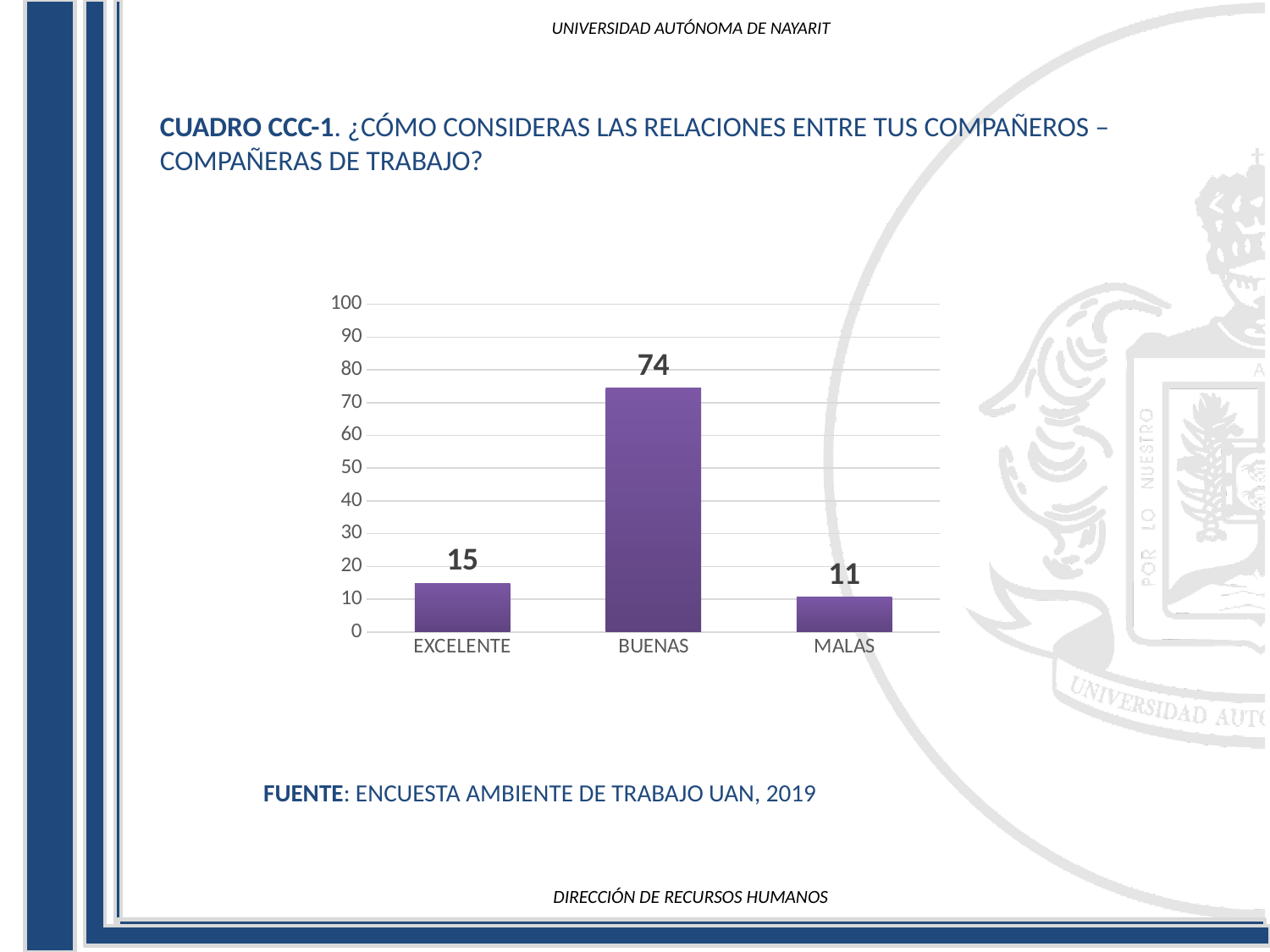
What is the value for BUENAS? 74 Which is larger, the value for EXCELENTE or the value for MALAS? EXCELENTE What is the difference between the values for BUENAS and EXCELENTE? 59 How many categories are shown on the x axis? 3 What is the value for EXCELENTE? 15 What kind of chart is shown on the slide? Bar chart What is the maximum value shown on the vertical axis? 100 Which category has the lowest value? MALAS Is the value for BUENAS greater or less than 50? greater What is the value for MALAS? 11 What is the difference between the values for EXCELENTE and MALAS? 4 Which category has the highest value? BUENAS